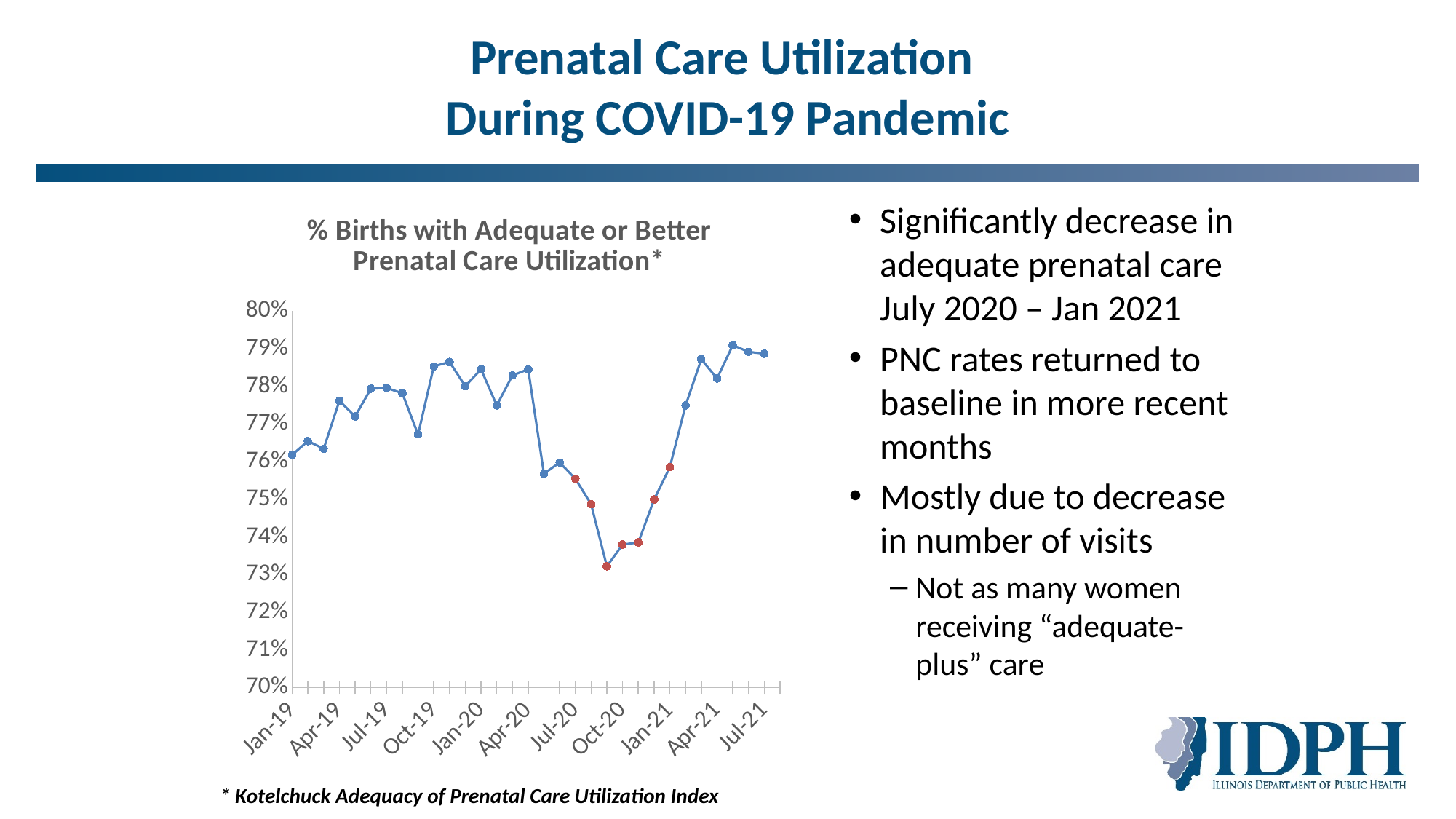
Does the line rise or fall between Jan-21 and Apr-21? Rise What is the title of the chart? % Births with Adequate or Better Prenatal Care Utilization* Does the line rise or fall between Jul-20 and Oct-20? Fall Is the lowest point on the line greater or less than 74%? less Is the value for Jul-21 greater or less than 78%? greater Is the value for Jul-19 greater or less than 77%? greater What kind of chart is shown on the slide? Line chart Which is larger, the value for Jan-20 or the value for Jan-21? Jan-20 How many labels are shown on the x axis of the chart? 11 Which is larger, the value for Jul-20 or the value for Jul-21? Jul-21